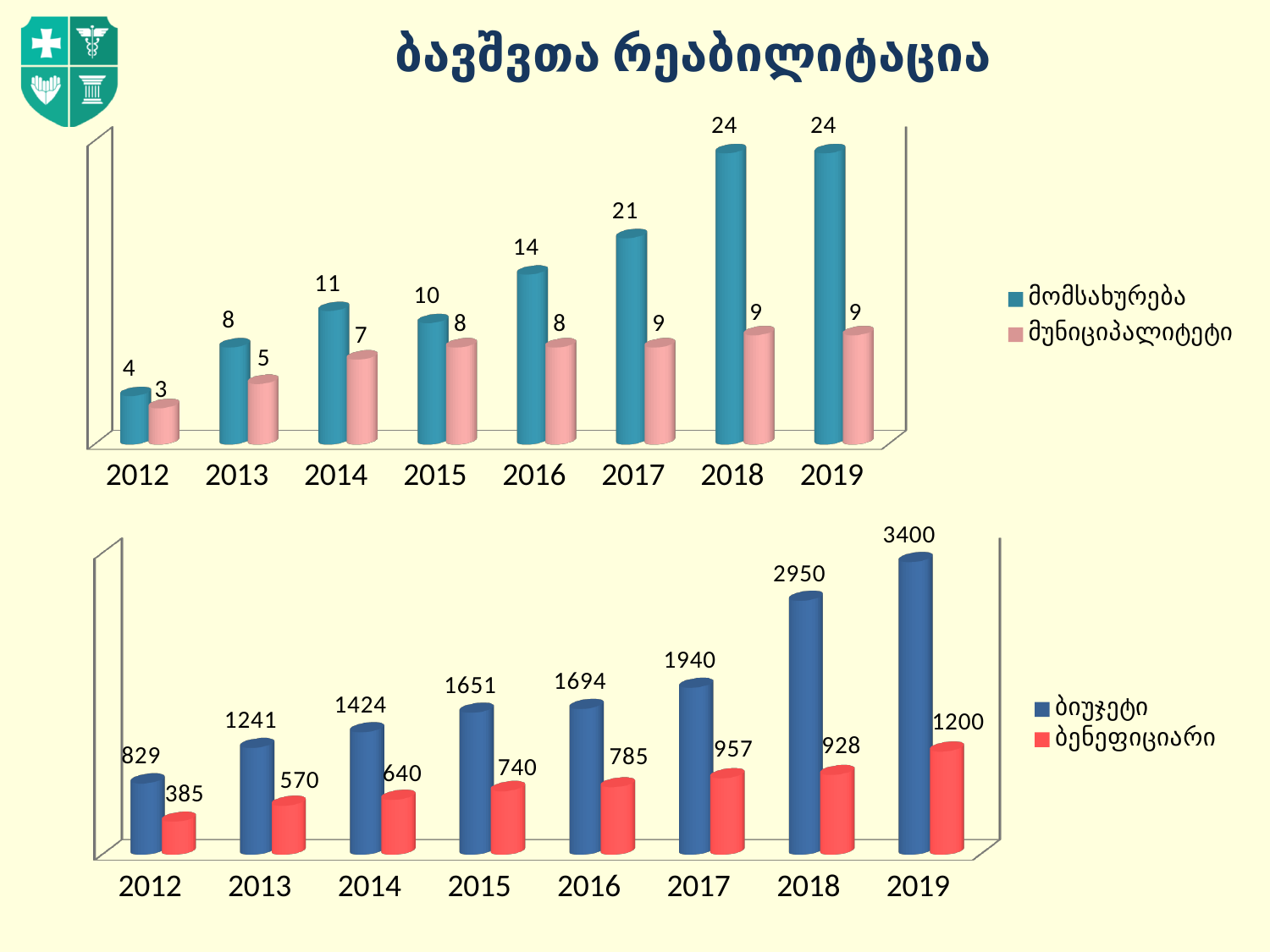
In the top chart, which year has the lowest მომსახურება value? 2012 In the top chart, what is the value for მუნიციპალიტეტი in 2014? 7 In the bottom chart, which is larger: the ბენეფიციარი value in 2017 or in 2018? 2017 In the bottom chart, what is the difference between the ბიუჯეტი values in 2019 and 2018? 450 In the bottom chart, which year has the highest ბიუჯეტი value? 2019 What type of chart is the bottom chart? Bar chart How many years are shown on the x axis of the bottom chart? 8 In the top chart, what is the value for მომსახურება in 2017? 21 In the top chart, how many series does the legend list? 2 In the top chart, what is the difference between the მომსახურება and მუნიციპალიტეტი values in 2018? 15 In the bottom chart, what is the value for ბენეფიციარი in 2019? 1200 In the bottom chart, what is the value for ბიუჯეტი in 2016? 1694